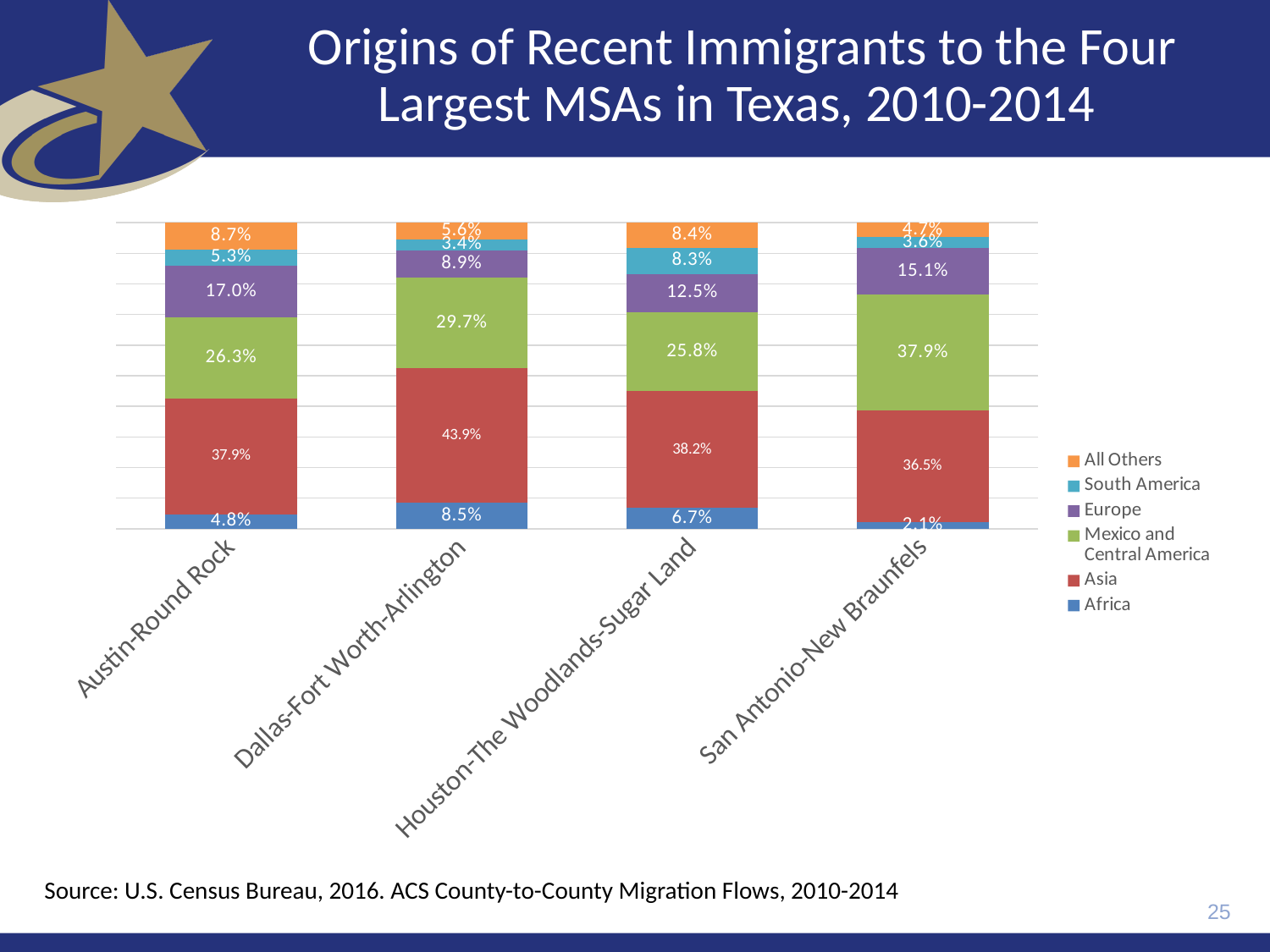
What share of recent immigrants to San Antonio-New Braunfels came from Mexico and Central America? 37.9% Which has the larger Mexico and Central America share, Austin-Round Rock or Houston-The Woodlands-Sugar Land? Austin-Round Rock How many percentage points higher is the Europe share for Austin-Round Rock than for Houston-The Woodlands-Sugar Land? 4.5 percentage points Which series is listed first (at the top) in the legend? All Others What share of recent immigrants to Dallas-Fort Worth-Arlington came from Asia? 43.9% How many MSAs are shown on the x axis? 4 How many series does the legend list? 6 What share of recent immigrants to Houston-The Woodlands-Sugar Land came from South America? 8.3% What share of recent immigrants to Austin-Round Rock came from Africa? 4.8% Which MSA has the lowest share of recent immigrants from Africa? San Antonio-New Braunfels Which MSA has the highest share of recent immigrants from Asia? Dallas-Fort Worth-Arlington What kind of chart is shown on the slide? Stacked bar chart